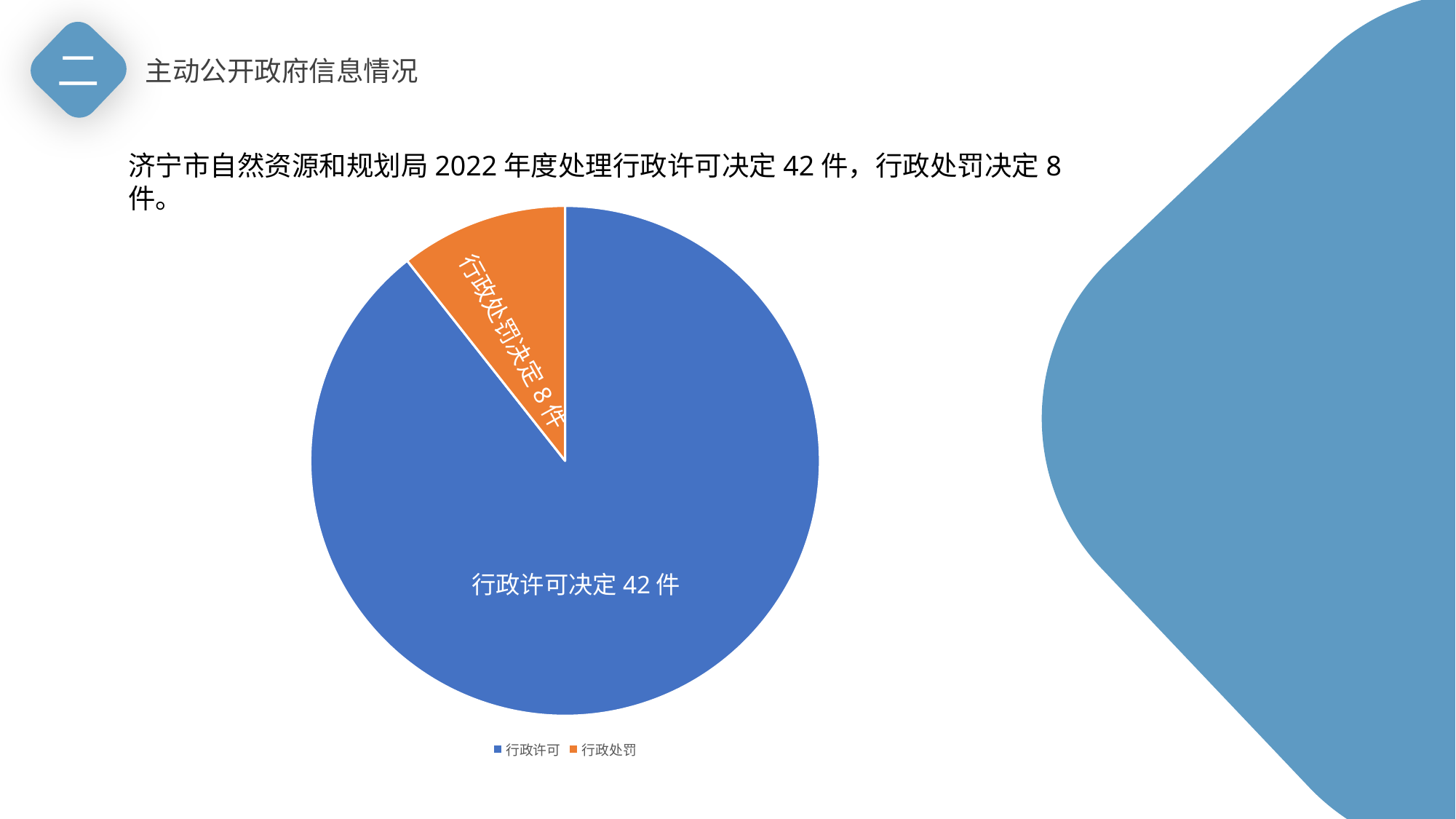
What value is labelled on the 行政处罚 slice of the pie chart? 8 件 Which is larger in the pie chart, 行政许可 or 行政处罚? 行政许可 How many slices does the pie chart have? 2 What kind of chart is shown on the slide? pie chart How many entries does the legend of the pie chart list? 2 What colour is the 行政处罚 slice in the pie chart? orange What is the total of the two values shown in the pie chart? 50 件 Which slice of the pie chart is the largest? 行政许可 What is the difference between the 行政许可 value and the 行政处罚 value in the pie chart? 34 件 What value is labelled on the 行政许可 slice of the pie chart? 42 件 Which slice of the pie chart is the smallest? 行政处罚